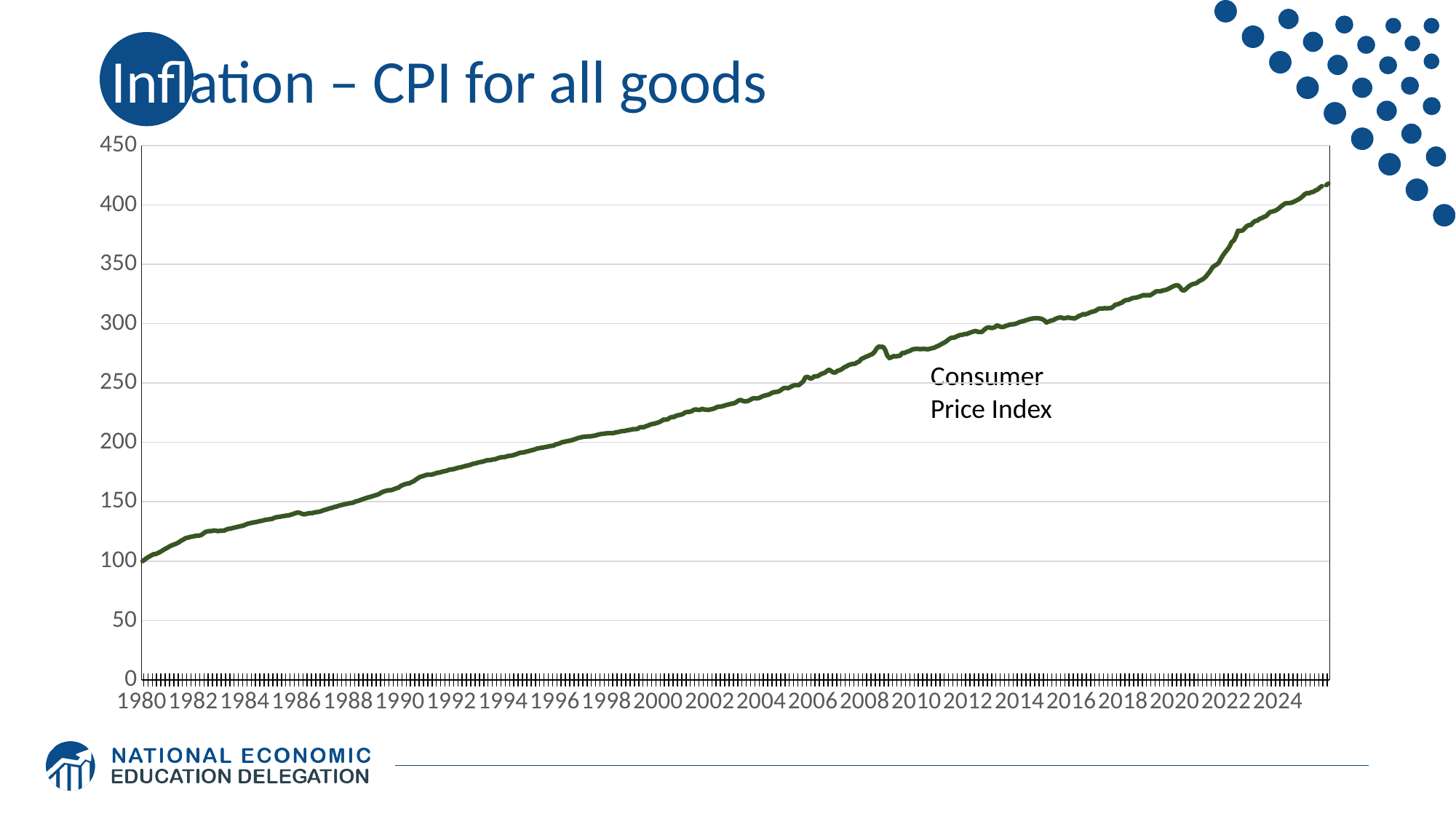
Is the value of the Consumer Price Index in 1990 greater or less than 150? greater Does the Consumer Price Index generally rise or fall from 1980 to 2024? rise Is the value of the Consumer Price Index in 2010 greater or less than 250? greater Is the value of the Consumer Price Index in 2022 greater or less than 350? greater What is the title of the slide's chart? Inflation – CPI for all goods What series label is printed next to the line on the chart? Consumer Price Index In which year shown on the x axis is the Consumer Price Index lowest? 1980 What is the highest value shown on the vertical axis? 450 Is the Consumer Price Index higher in 2020 or in 1996? 2020 What kind of chart is shown on the slide? line chart